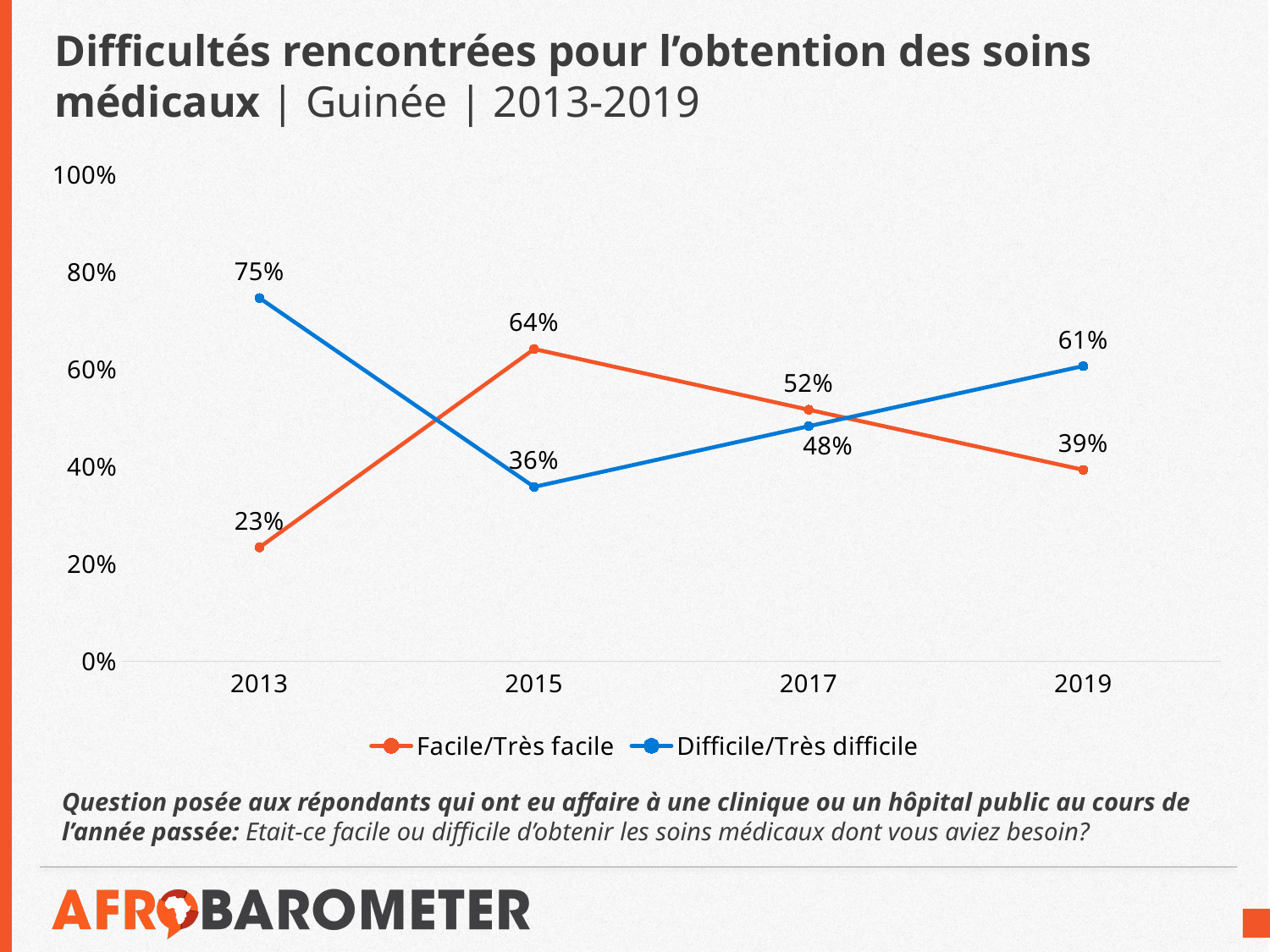
What value does the Facile/Très facile series show for 2015? 64% In 2019, which series has the larger value, Facile/Très facile or Difficile/Très difficile? Difficile/Très difficile In which year is the Facile/Très facile series at its highest? 2015 Does the Facile/Très facile series rise or fall from 2015 to 2019? Fall How many series does the legend list? 2 What value does the Facile/Très facile series show for 2019? 39% What value does the Difficile/Très difficile series show for 2013? 75% How many years are plotted on the x axis? 4 What is the difference between the Difficile/Très difficile and Facile/Très facile values in 2013? 52 percentage points What value does the Difficile/Très difficile series show for 2017? 48% In which year is the Difficile/Très difficile series at its lowest? 2015 What kind of chart is shown on the slide? Line chart